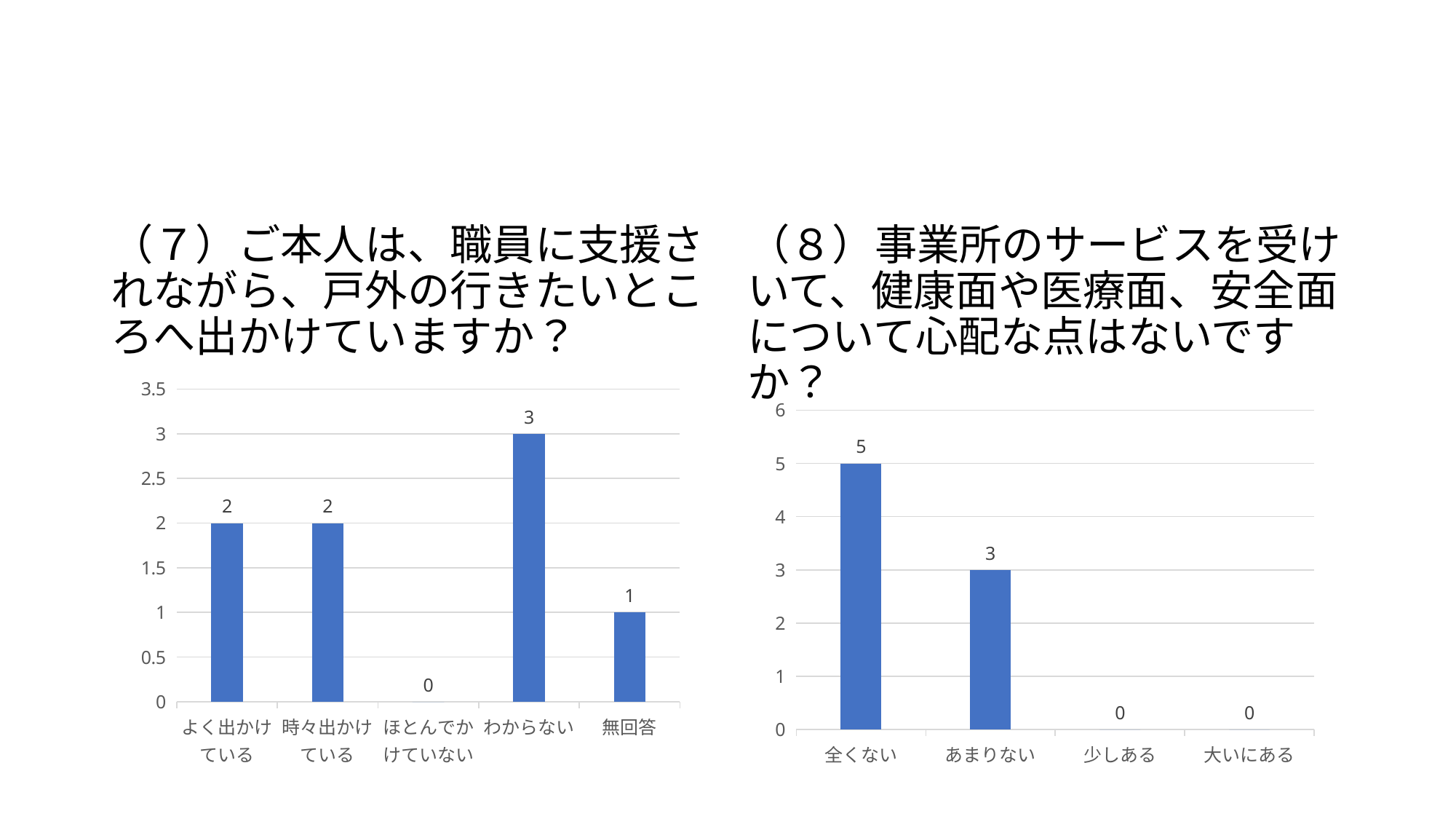
In the left chart (7), what is the value for わからない? 3 In the right chart (8), which is larger, 全くない or あまりない? 全くない In the right chart (8), what is the value for 全くない? 5 In the left chart (7), which category has the lowest value? ほとんでかけていない In the left chart (7), what is the difference between わからない and 無回答? 2 In the left chart (7), what is the value for 無回答? 1 In the left chart (7), how many categories are shown on the x axis? 5 In the left chart (7), which category has the highest value? わからない In the right chart (8), what is the value for あまりない? 3 In the right chart (8), which category has the highest value? 全くない What kind of chart is the right chart (8)? Bar chart In the right chart (8), what is the difference between 全くない and あまりない? 2